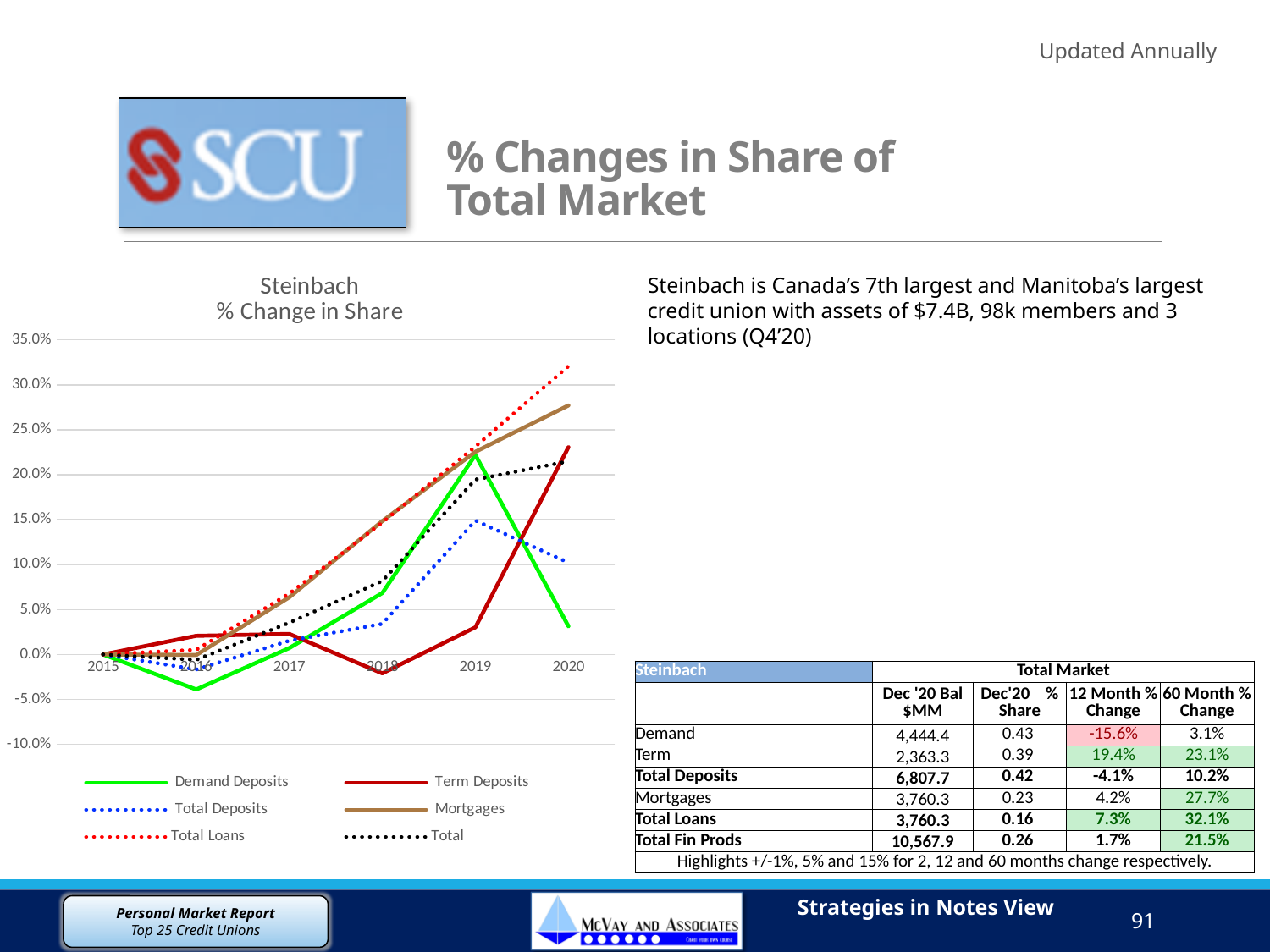
Which series has the lowest value in 2020? Demand Deposits Which series has the highest value in 2020? Total Loans Is the value for Demand Deposits in 2016 greater or less than 0.0%? less What is the title of the chart? Steinbach % Change in Share Is the value for Demand Deposits in 2020 greater or less than 5.0%? less How many series does the legend of the chart list? 6 What kind of chart is shown on the slide? line chart Is the value for Mortgages in 2020 greater or less than 25.0%? greater How many years are shown along the x axis of the chart? 6 In 2020, which is larger: Term Deposits or Total Deposits? Term Deposits Does the Mortgages line rise or fall from 2015 to 2020? rise